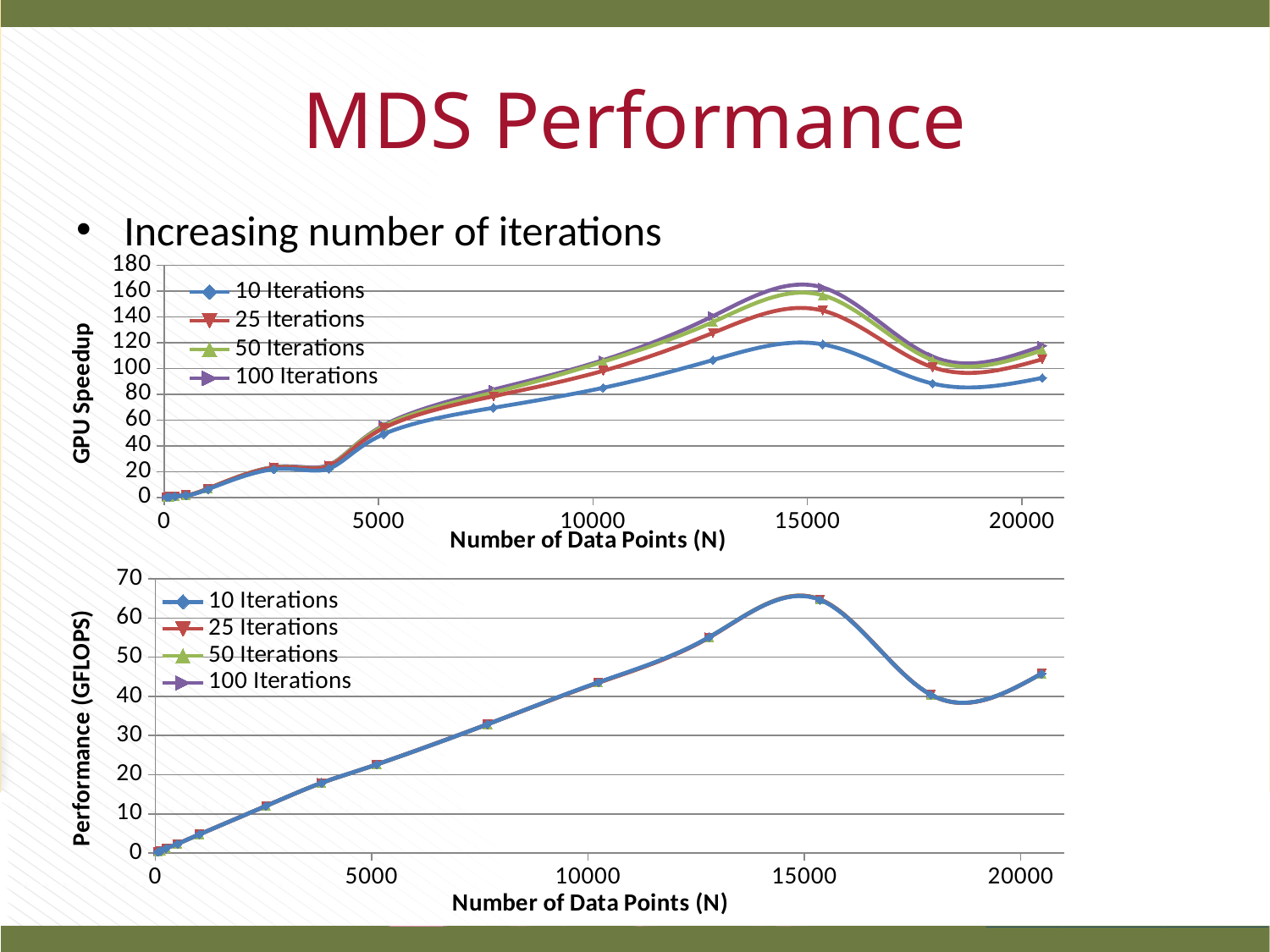
In the top chart (GPU Speedup), at about 15000 data points, which is larger: the value for 25 Iterations or the value for 10 Iterations? 25 Iterations How many series does the legend of the top chart (GPU Speedup) list? 4 What kind of chart is the bottom chart (Performance (GFLOPS))? line chart In the top chart (GPU Speedup), is the value for 100 Iterations at about 15000 data points greater or less than 140? greater How many series does the legend of the bottom chart (Performance (GFLOPS)) list? 4 In the top chart (GPU Speedup), which series reaches the highest speedup at its peak near 15000 data points? 100 Iterations What kind of chart is the top chart (GPU Speedup)? line chart In the bottom chart (Performance (GFLOPS)), is the value at about 20000 data points greater or less than 50? less In the top chart (GPU Speedup), is the value for 10 Iterations at about 20000 data points greater or less than 100? less In the top chart (GPU Speedup), which series has the lowest speedup at around 15000 data points? 10 Iterations What is the x-axis title of the bottom chart? Number of Data Points (N)